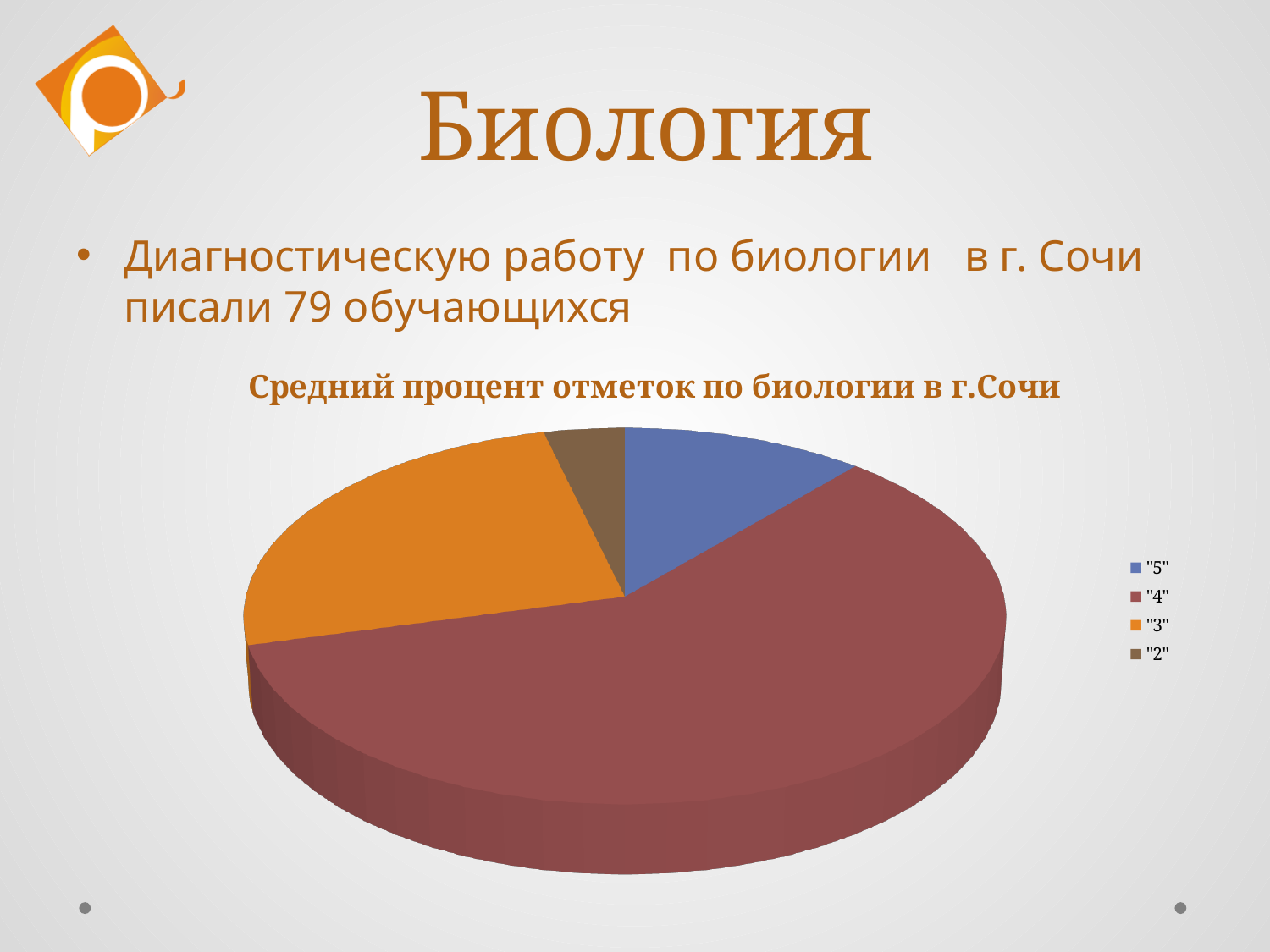
How many slices does the pie chart have? 4 What is the title of the chart? Средний процент отметок по биологии в г.Сочи Which slice is larger, "4" or "3"? "4" Which grade has the smallest slice of the pie? "2" Which slice is larger, "3" or "5"? "3" How many entries does the chart legend list? 4 Which slice is larger, "5" or "2"? "5" Which grade has the largest slice of the pie? "4" What kind of chart is shown on the slide? pie chart Which colour represents the grade "3" in the chart? orange